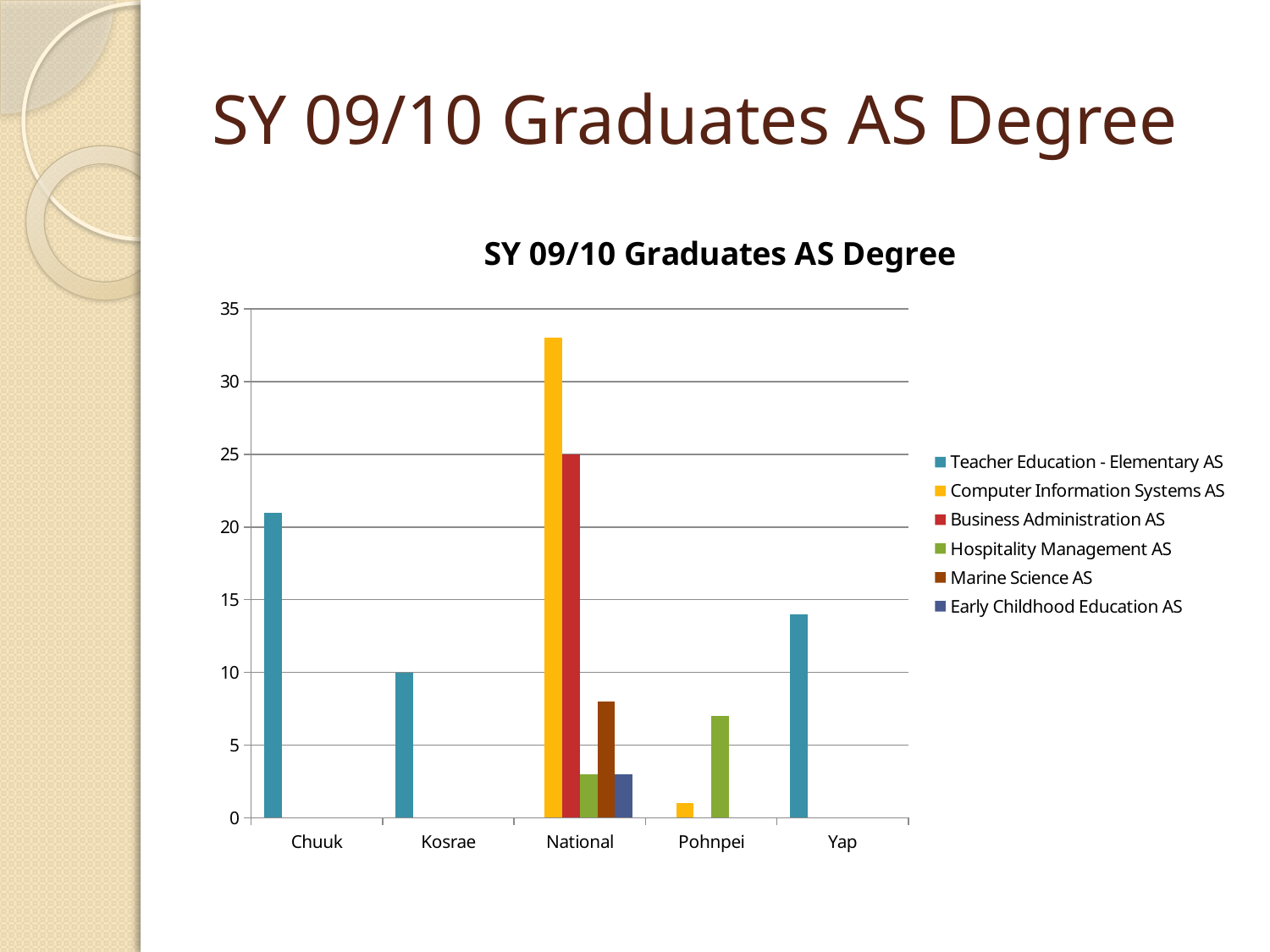
Which category has the highest bar in the chart? National What kind of chart is shown on the slide? bar chart What is the title of the chart? SY 09/10 Graduates AS Degree What is the value for Business Administration AS in National? 25 What is the value for Teacher Education - Elementary AS in Kosrae? 10 Which is larger: Teacher Education - Elementary AS in Chuuk or in Yap? Chuuk Is the value for Computer Information Systems AS in National greater or less than 30? greater Is the value for Teacher Education - Elementary AS in Chuuk greater or less than 20? greater Which series has the tallest bar in the National category? Computer Information Systems AS How many series does the legend list? 6 Is the value for Teacher Education - Elementary AS in Yap greater or less than 15? less How many categories are shown on the x axis? 5